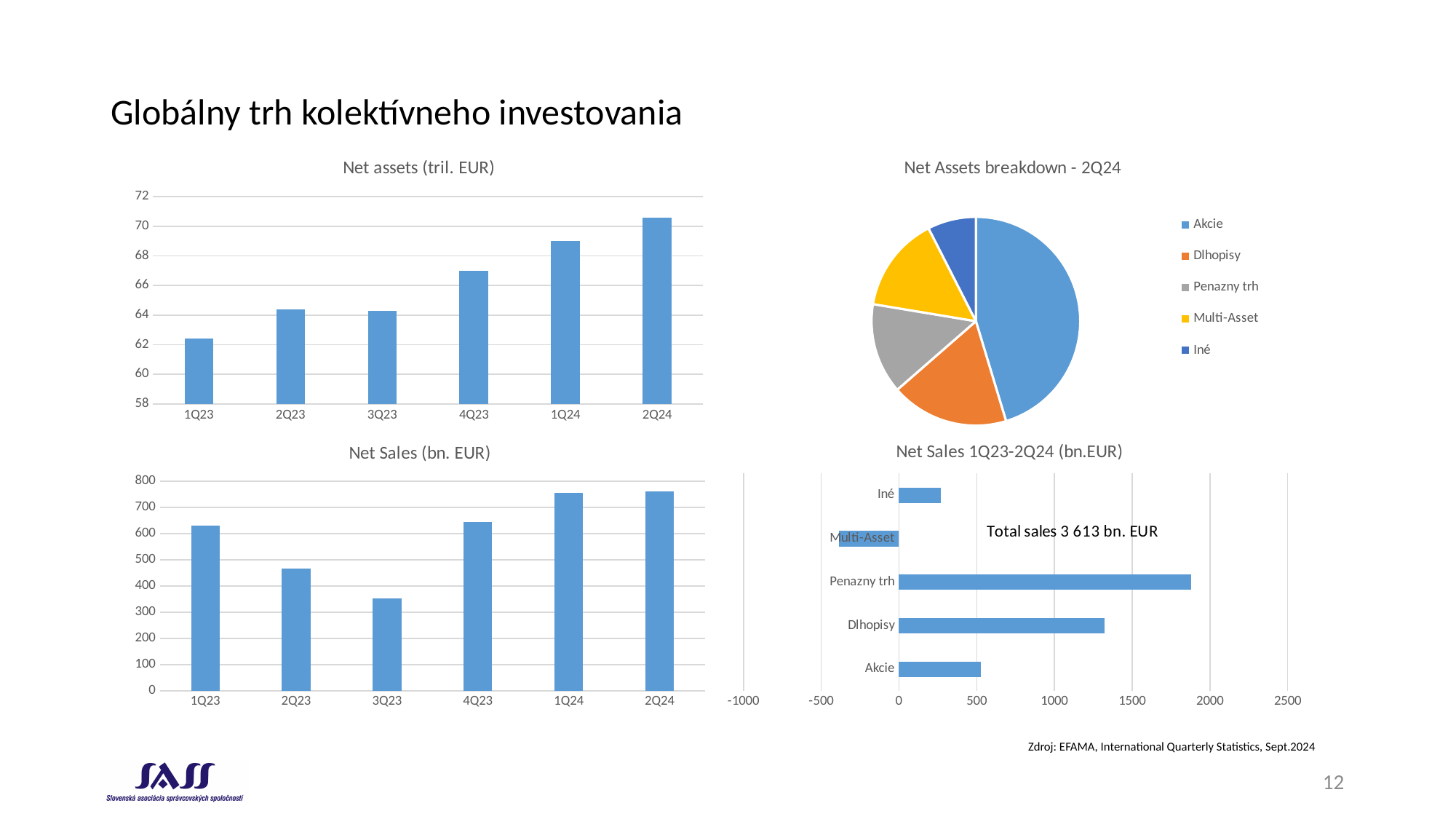
In the 'Net Sales 1Q23-2Q24 (bn.EUR)' chart, which category has the highest net sales? Penazny trh How many categories does the legend of the 'Net Assets breakdown - 2Q24' chart list? 5 In the 'Net Sales 1Q23-2Q24 (bn.EUR)' chart, is the value for Multi-Asset greater or less than 0? less In the 'Net assets (tril. EUR)' chart, which quarter has the lowest net assets? 1Q23 In the 'Net Sales (bn. EUR)' chart, which quarter has the lowest net sales? 3Q23 In the 'Net assets (tril. EUR)' chart, is the value for 1Q23 greater or less than 64? less In the 'Net assets (tril. EUR)' chart, how many quarters are plotted? 6 In the 'Net Assets breakdown - 2Q24' pie chart, which category has the largest slice? Akcie In the 'Net Sales (bn. EUR)' chart, is the value for 3Q23 greater or less than 400? less In the 'Net Assets breakdown - 2Q24' pie chart, which category has the smallest slice? Iné In the 'Net assets (tril. EUR)' chart, which quarter has the highest net assets? 2Q24 In the 'Net Sales (bn. EUR)' chart, which is larger, the value for 1Q23 or 2Q23? 1Q23